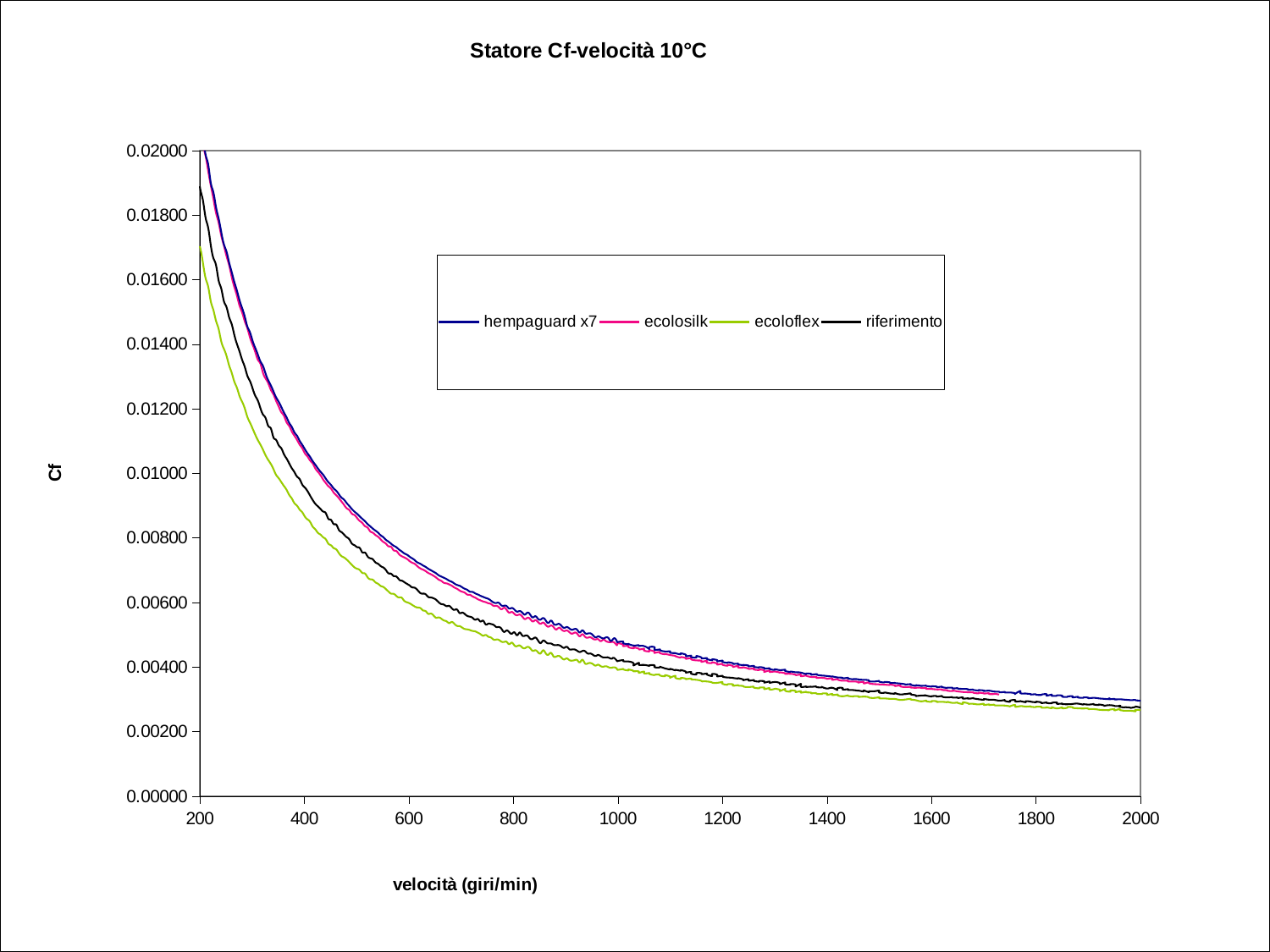
What is the title of the chart? Statore Cf-velocità 10°C Is the Cf value for ecoloflex at 200 giri/min greater or less than 0.01800? less What kind of chart is shown on the slide? line chart At 1000 giri/min, which series has the larger Cf value, hempaguard x7 or ecoloflex? hempaguard x7 Is the Cf value for hempaguard x7 at 1000 giri/min greater or less than 0.00400? greater Which series has the lowest Cf values across the velocità range? ecoloflex What is the label of the x axis? velocità (giri/min) How many series does the legend list? 4 Is the Cf value for ecoloflex at 400 giri/min greater or less than 0.01000? less Do the Cf values rise or fall as velocità increases along the x axis? fall